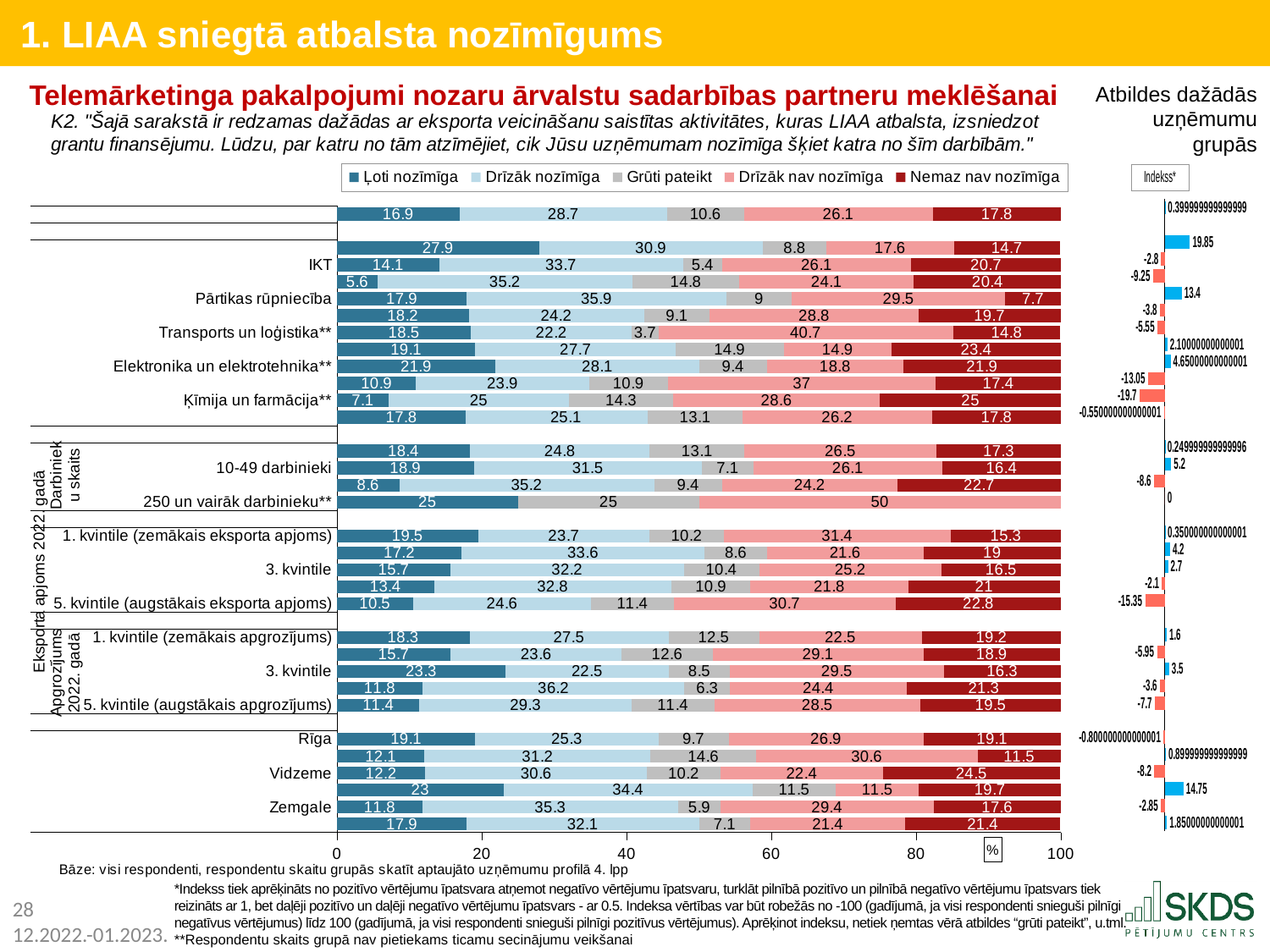
What is the value of "Drīzāk nav nozīmīga" for Transports un loģistika**? 40.7 What is the first entry in the chart legend? Ļoti nozīmīga How many series does the legend of the stacked bar chart list? 5 What is the value of "Grūti pateikt" for 5. kvintile (augstākais apgrozījums)? 11.4 What is the value of "Ļoti nozīmīga" for Ķīmija un farmācija**? 7.1 What is the value of "Drīzāk nav nozīmīga" for 250 un vairāk darbinieku**? 50 Which has a larger "Nemaz nav nozīmīga" value, Rīga or Vidzeme? Vidzeme What is the difference between the "Ļoti nozīmīga" values for Elektronika un elektrotehnika** and Ķīmija un farmācija**? 14.8 What is the value of "Nemaz nav nozīmīga" for Pārtikas rūpniecība? 7.7 What kind of chart is used to show the responses by company group? Stacked bar chart What is the value of "Ļoti nozīmīga" for IKT? 14.1 What is the value of "Drīzāk nozīmīga" for Zemgale? 35.3